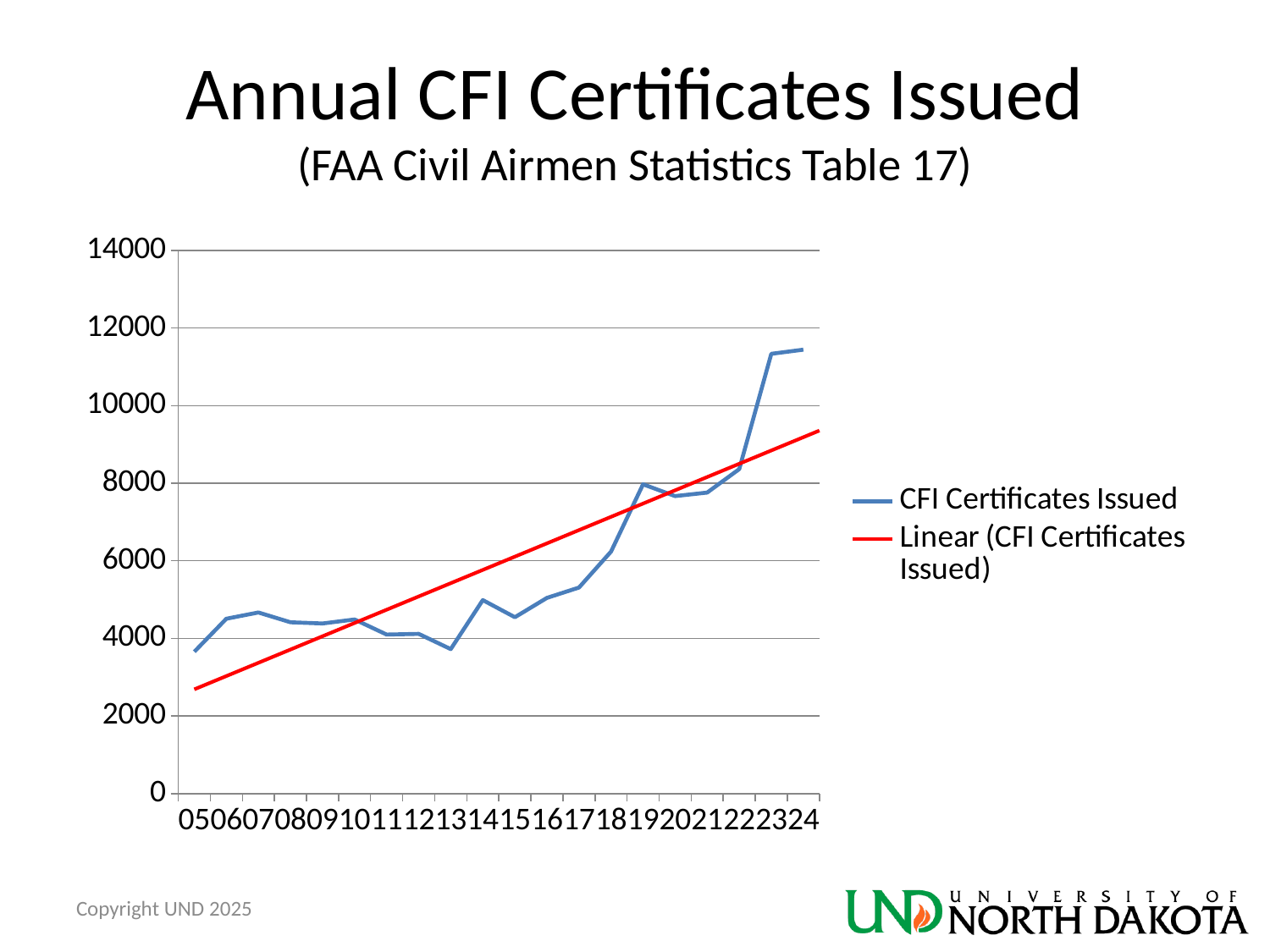
Is the value for CFI Certificates Issued in 13 greater or less than 4000? less How many years are plotted along the x axis? 20 Is the value for CFI Certificates Issued in 24 greater or less than 10000? greater What colour is the Linear (CFI Certificates Issued) trendline? red Which is larger, the CFI Certificates Issued value for 24 or for 05? 24 What is the title of the chart? Annual CFI Certificates Issued (FAA Civil Airmen Statistics Table 17) Is the value for CFI Certificates Issued in 22 greater or less than 8000? greater How many series does the legend list? 2 Overall, do the CFI Certificates Issued values rise or fall from 05 to 24? rise What kind of chart is shown on the slide? line chart